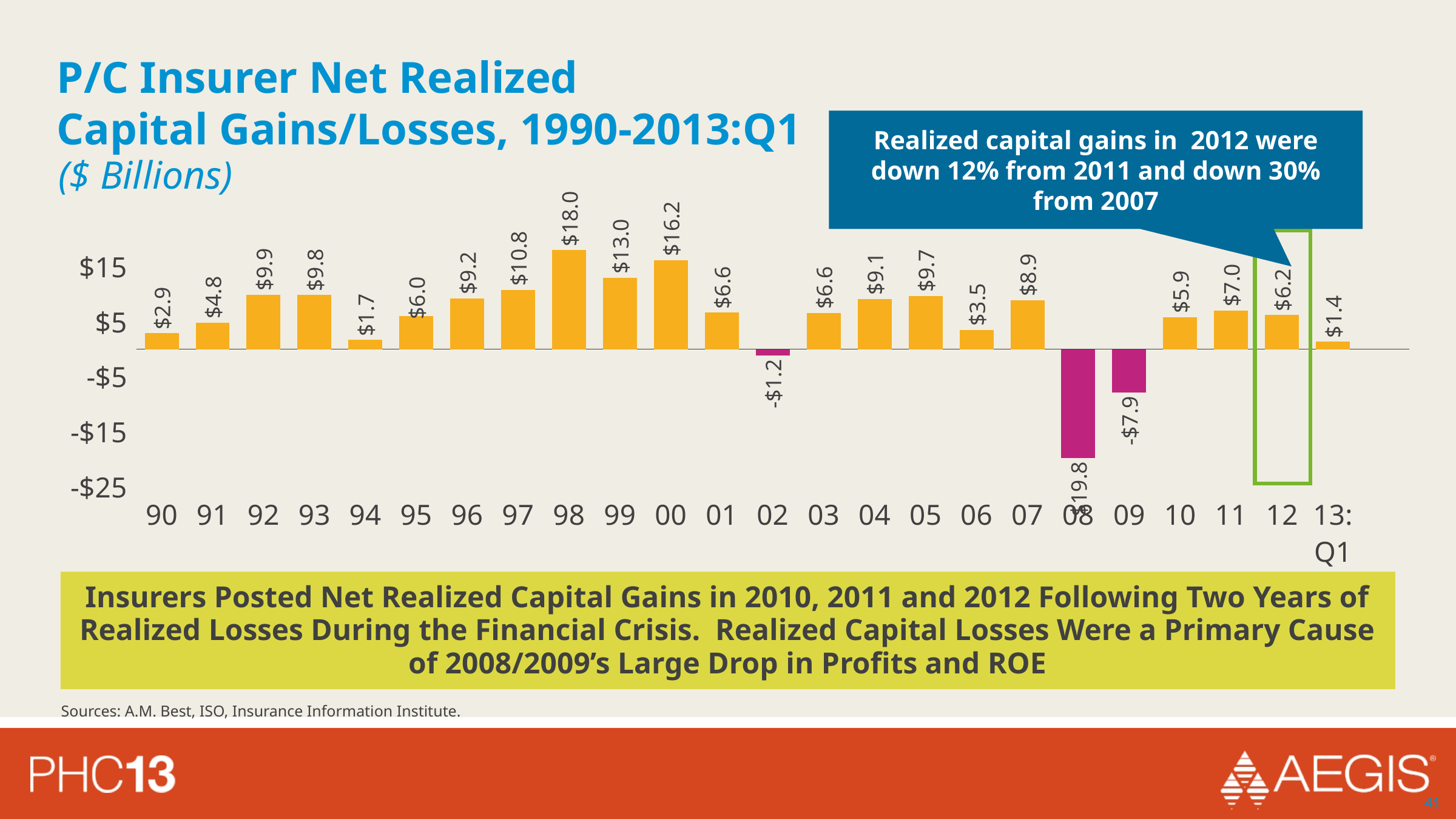
Which year has the lowest value on the chart? 08 Which year has the highest net realized capital gain? 98 How many periods are plotted on the x axis? 24 Which is larger, the value for 1999 or the value for 2000? 2000 What was the net realized capital gain in 1998? $18.0 What value is shown for 2008? -$19.8 What value is shown for 2013:Q1? $1.4 What kind of chart is shown on the slide? bar chart What is the difference between the values for 2011 and 2012? $0.8 Do the values rise or fall from 1994 to 1998? rise Is the value for 2008 greater or less than -$15? less What is the difference between the values for 1998 and 2000? $1.8